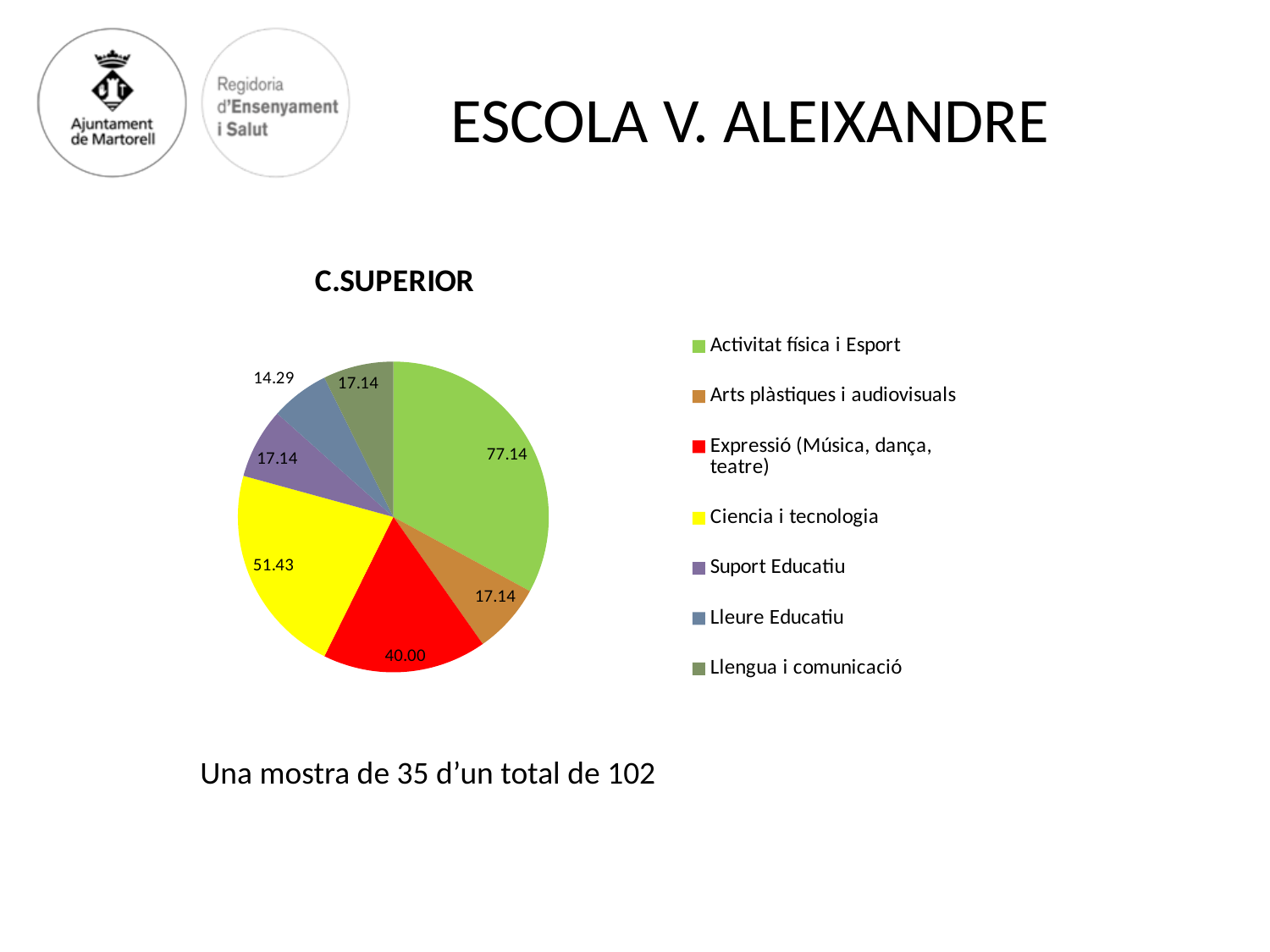
Which category has the largest slice of the pie? Activitat física i Esport What is the value shown for Ciencia i tecnologia? 51.43 Which category has the smallest slice of the pie? Lleure Educatiu Which is larger, the value for Expressió (Música, dança, teatre) or the value for Ciencia i tecnologia? Ciencia i tecnologia What is the value shown for Expressió (Música, dança, teatre)? 40.00 What type of chart is shown on the slide? pie chart What is the difference between the values for Activitat física i Esport and Ciencia i tecnologia? 25.71 What is the title of the chart? C.SUPERIOR How many categories does the legend of the pie chart list? 7 What is the value shown for Lleure Educatiu? 14.29 What is the value shown for Activitat física i Esport? 77.14 What colour is the slice for Ciencia i tecnologia? yellow